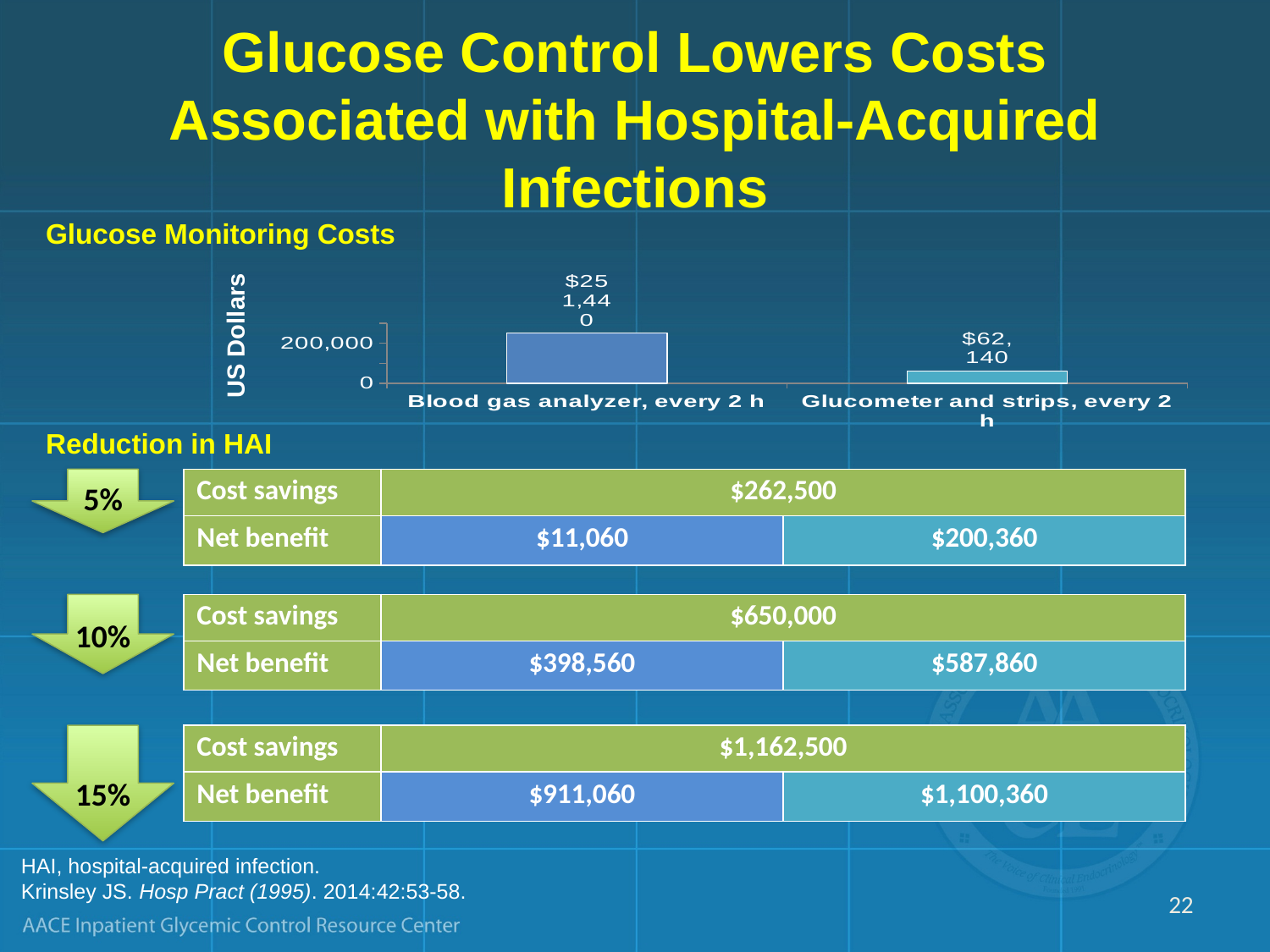
What is the title of the chart on the slide? Glucose Monitoring Costs In the Glucose Monitoring Costs chart, what is the value for Glucometer and strips, every 2 h? $62,140 In the Glucose Monitoring Costs chart, is the value for Blood gas analyzer, every 2 h greater or less than 200,000? greater In the Glucose Monitoring Costs chart, which is larger: the cost for Blood gas analyzer, every 2 h or for Glucometer and strips, every 2 h? Blood gas analyzer, every 2 h In the Glucose Monitoring Costs chart, what is the value for Blood gas analyzer, every 2 h? $251,440 In the Glucose Monitoring Costs chart, which category has the lowest cost? Glucometer and strips, every 2 h What is the label on the vertical axis of the Glucose Monitoring Costs chart? US Dollars What type of chart is the Glucose Monitoring Costs chart? bar chart In the Glucose Monitoring Costs chart, is the value for Glucometer and strips, every 2 h greater or less than 200,000? less In the Glucose Monitoring Costs chart, what is the difference between the Blood gas analyzer cost and the Glucometer and strips cost? $189,300 How many categories are shown in the Glucose Monitoring Costs chart? 2 In the Glucose Monitoring Costs chart, which category has the highest cost? Blood gas analyzer, every 2 h